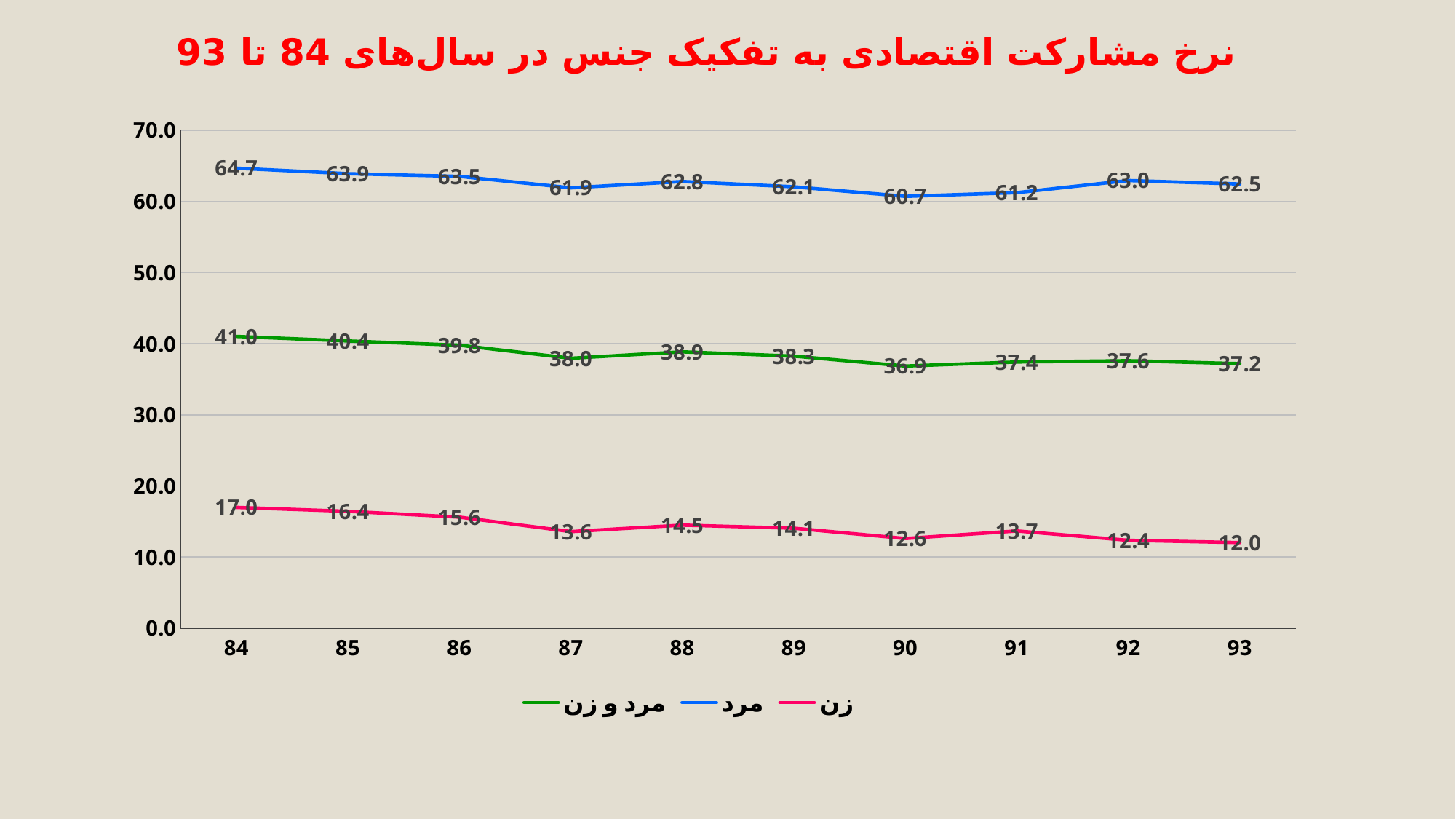
How many years are shown on the x axis? 10 What is the value of the مرد و زن (men and women) series in year 90? 36.9 What kind of chart is shown on the slide? line chart Is the value of the زن (women) series in year 87 greater or less than 20.0? less How many series does the legend list? 3 What is the value of the زن (women) series in year 93? 12.0 In which year is the مرد (men) series at its lowest? 90 In which year is the زن (women) series at its highest? 84 What is the value of the مرد (men) series in year 84? 64.7 Does the زن (women) series generally rise or fall from year 84 to year 93? fall Which is larger: the مرد و زن (men and women) value in year 88 or in year 89? 88 What is the difference between the مرد (men) value and the زن (women) value in year 93? 50.5